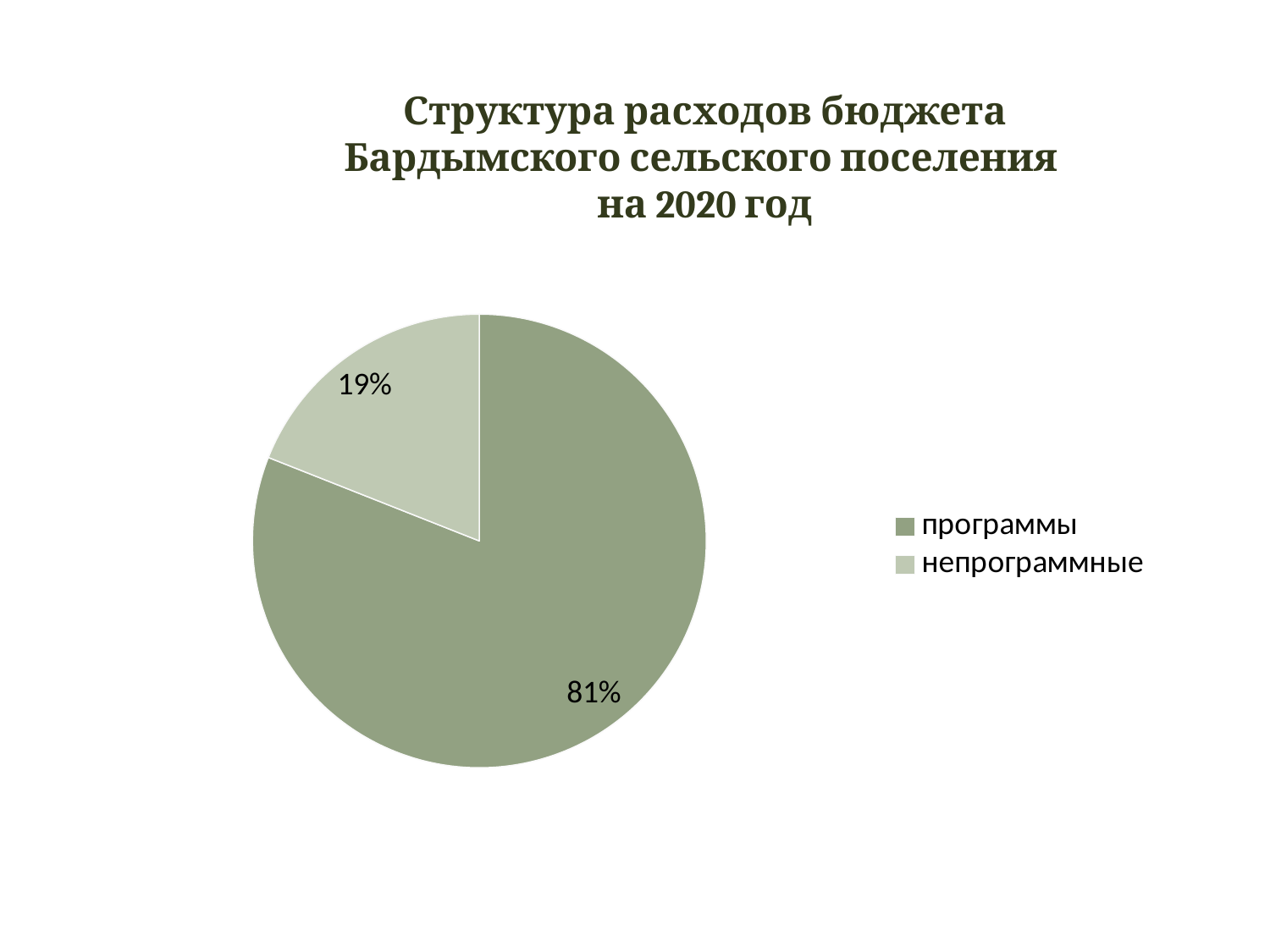
Which is larger, the "программы" slice or the "непрограммные" slice? программы Which category has the largest slice of the pie? программы What kind of chart is shown on the slide? pie chart Which category has the smallest slice of the pie? непрограммные What is the title of the chart? Структура расходов бюджета Бардымского сельского поселения на 2020 год Which legend entry is shown in the lighter green colour? непрограммные What share of the pie does the "программы" slice represent? 81% How many entries does the legend list? 2 What is the difference in percentage points between the "программы" and "непрограммные" slices? 62 How many slices does the pie chart have? 2 What share of the pie does the "непрограммные" slice represent? 19%